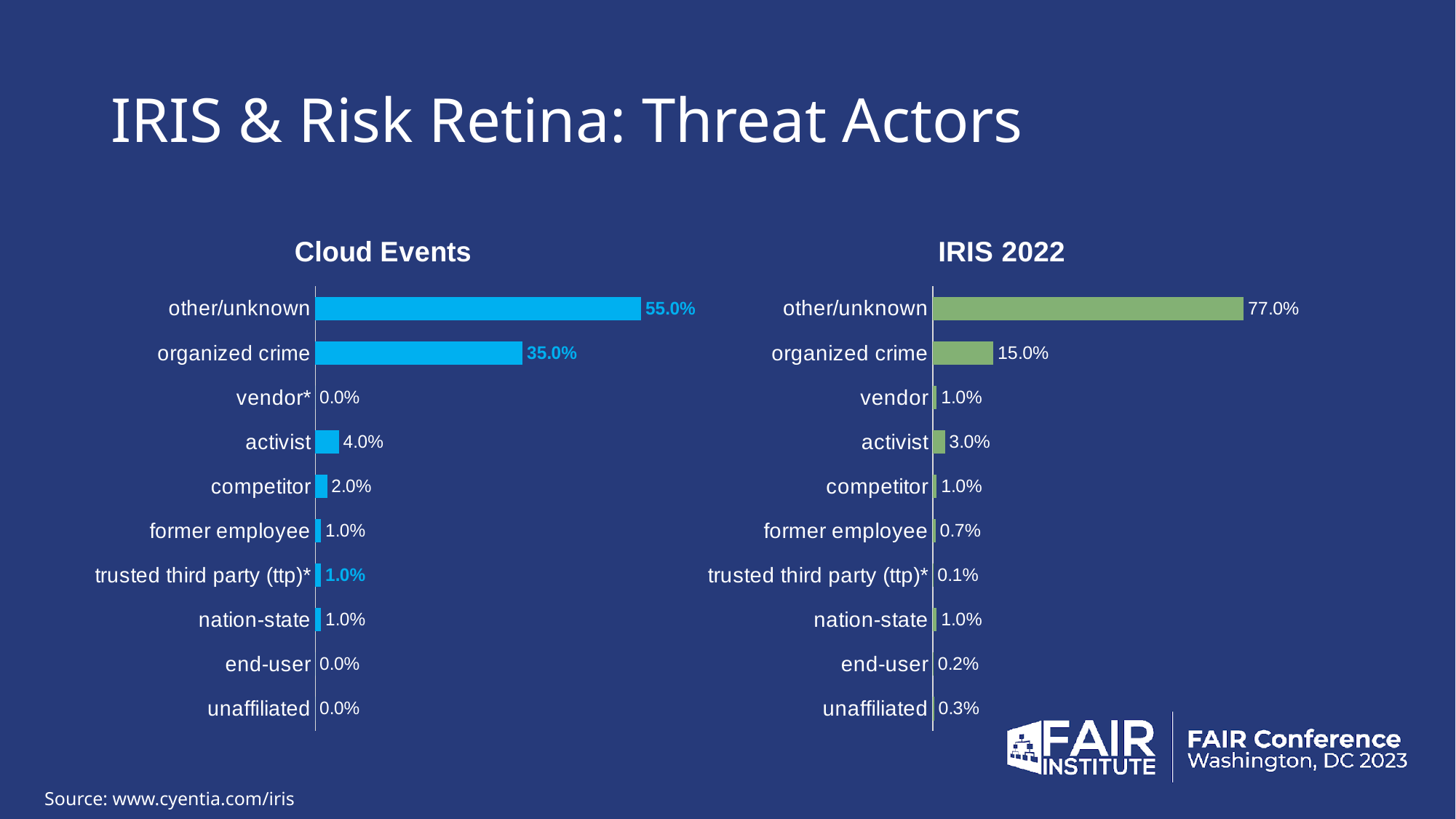
In the IRIS 2022 chart, what is the value for other/unknown? 77.0% Which is larger: organized crime in the Cloud Events chart or organized crime in the IRIS 2022 chart? Cloud Events In the IRIS 2022 chart, which category has the highest value? other/unknown In the Cloud Events chart, what is the value for activist? 4.0% What kind of chart is the IRIS 2022 chart? bar chart In the IRIS 2022 chart, which category has the lowest value? trusted third party (ttp)* In the Cloud Events chart, what is the value for organized crime? 35.0% What colour are the bars in the Cloud Events chart? blue In the IRIS 2022 chart, what is the value for former employee? 0.7% In the Cloud Events chart, what is the difference between other/unknown and organized crime? 20.0% How many categories does the Cloud Events chart show? 10 In the IRIS 2022 chart, what is the difference between other/unknown and organized crime? 62.0%